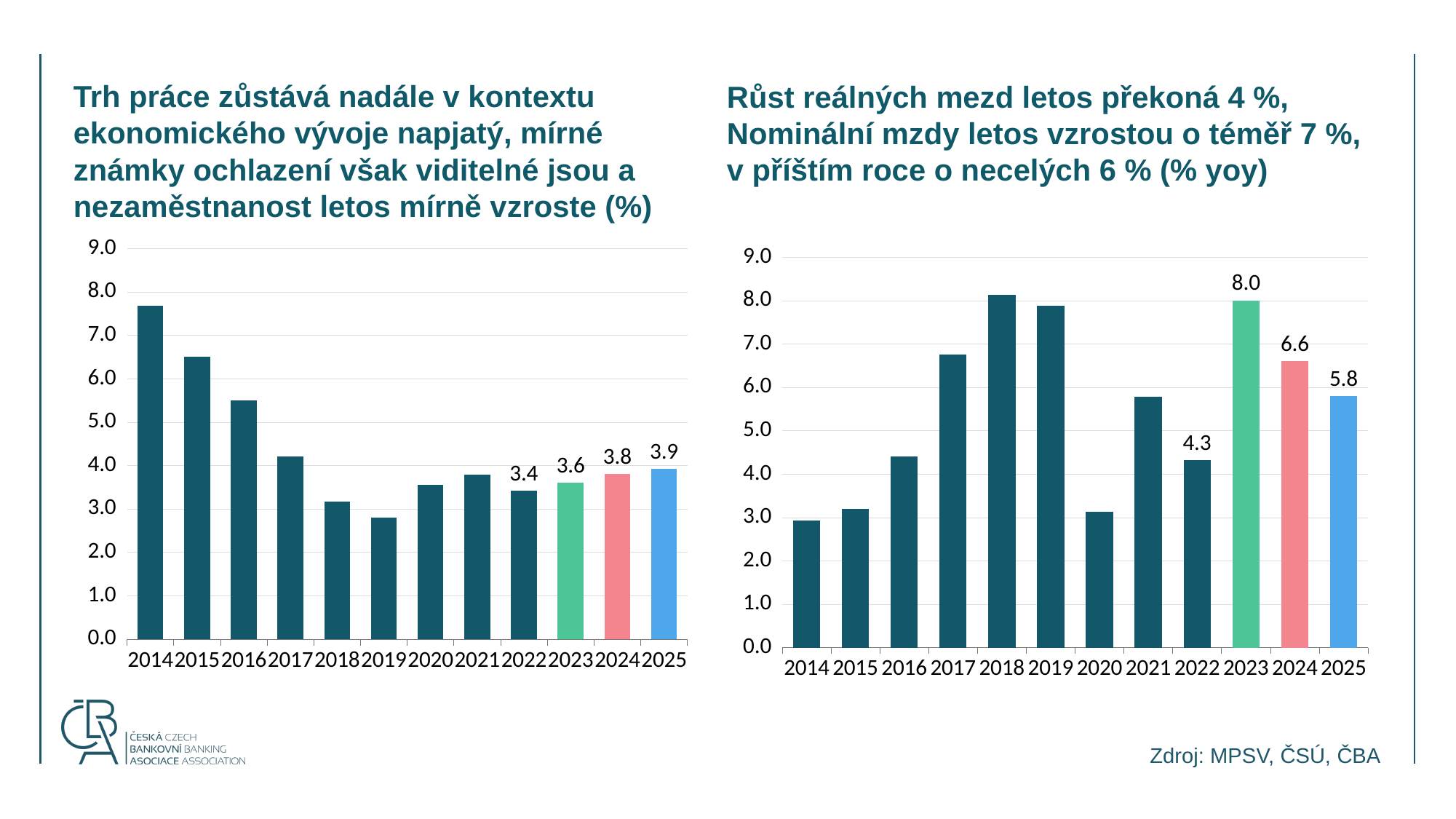
In the left chart (unemployment), which year has the lowest value? 2019 What kind of chart is the right chart (nominal wages)? bar chart In the left chart (unemployment), what is the value for 2025? 3.9 In the left chart (unemployment), is the value for 2014 greater or less than 7.0? greater In the left chart (unemployment), which year has the highest value? 2014 In the left chart (unemployment), what is the difference between the 2025 and 2022 values? 0.5 In the left chart (unemployment), what is the value for 2022? 3.4 In the right chart (nominal wages), what is the difference between the 2023 and 2024 values? 1.4 In the right chart (nominal wages), what is the value for 2023? 8.0 In the right chart (nominal wages), is the value for 2020 greater or less than 4.0? less How many years are shown on the x axis of the left chart (unemployment)? 12 In the right chart (nominal wages), which is larger, the value for 2023 or the value for 2025? 2023